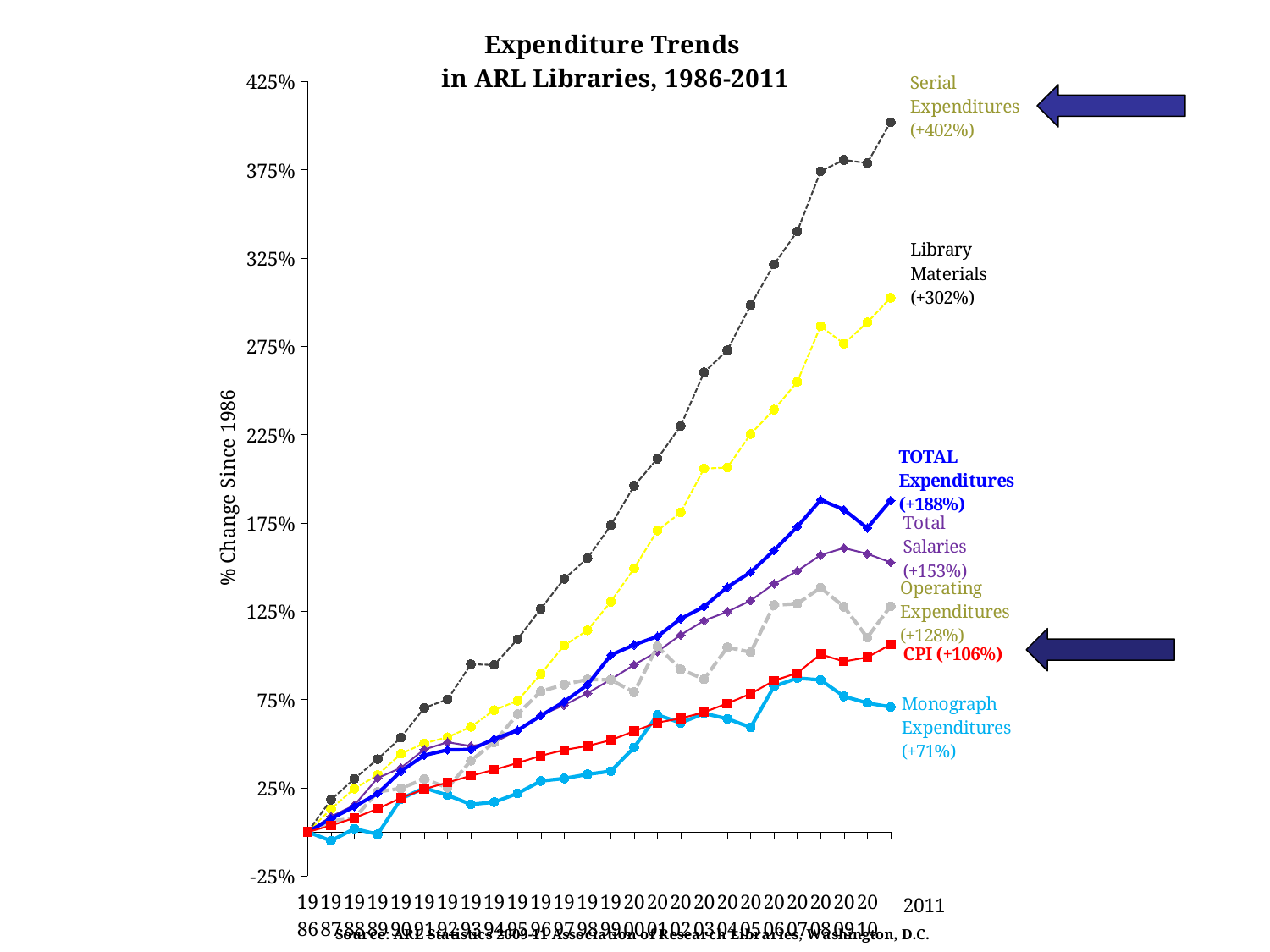
How many series are plotted on the chart? 7 Which series shows the highest percentage change since 1986 by 2011? Serial Expenditures What is the difference between the 2011 percentage change for Serial Expenditures and for Library Materials? 100% What is the percentage change since 1986 shown for Monograph Expenditures in 2011? +71% What kind of chart is shown on the slide? line chart Which is larger in 2011: the percentage change for Total Salaries or for Operating Expenditures? Total Salaries What is the percentage change since 1986 shown for CPI in 2011? +106% Does the Serial Expenditures line generally rise or fall from 1986 to 2011? rise What is the percentage change since 1986 shown for Library Materials in 2011? +302% What is the percentage change since 1986 shown for Serial Expenditures in 2011? +402% What is the title of the chart? Expenditure Trends in ARL Libraries, 1986-2011 Which series shows the lowest percentage change since 1986 by 2011? Monograph Expenditures